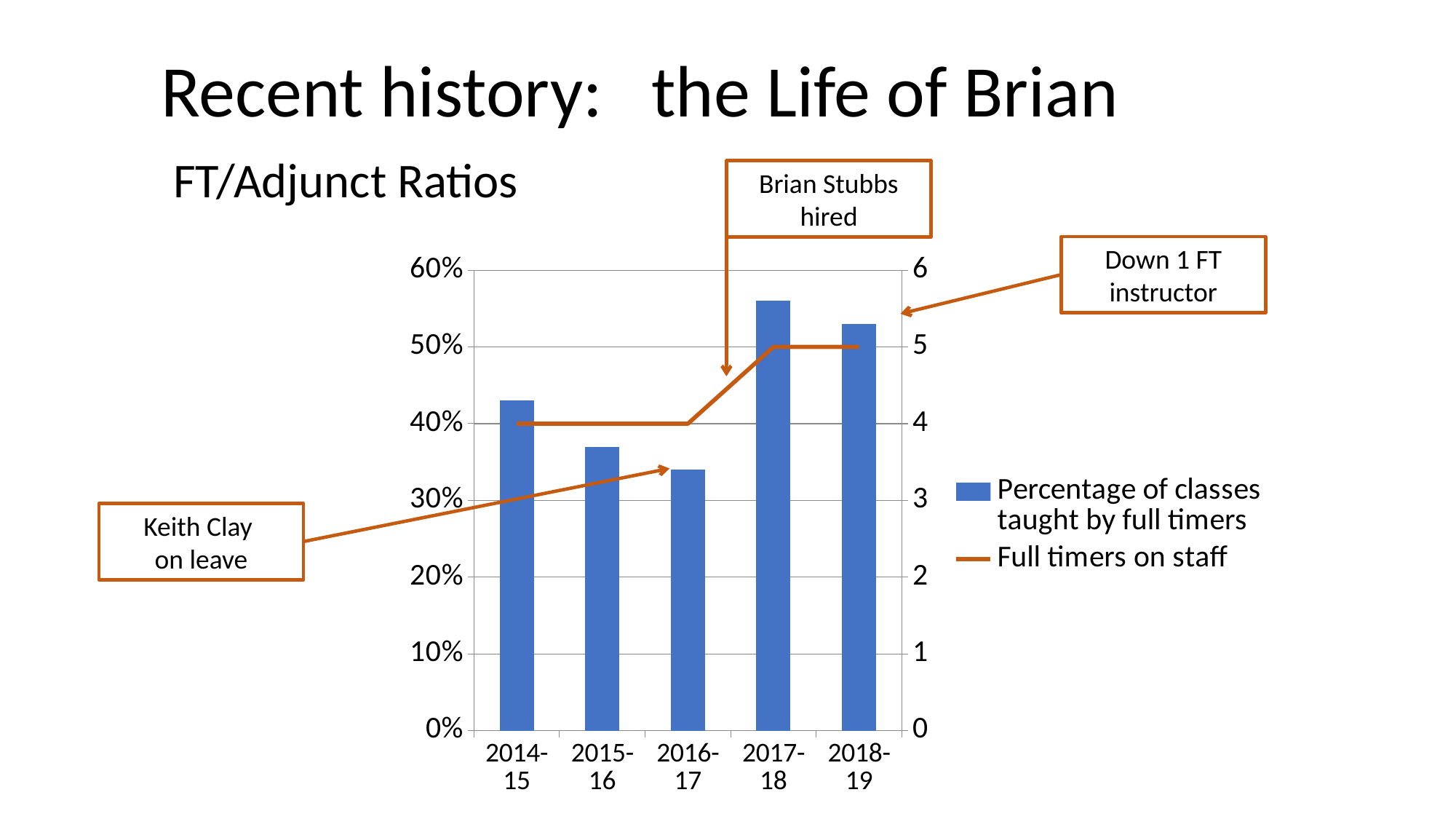
Is the percentage of classes taught by full timers in 2017-18 greater or less than 50%? greater Is the percentage of classes taught by full timers in 2016-17 greater or less than 40%? less What is the title of the chart? FT/Adjunct Ratios Which year has the highest percentage of classes taught by full timers? 2017-18 What kind of chart is shown on the slide? A bar chart combined with a line How many full timers were on staff in 2014-15? 4 How many series does the legend list? 2 What is the difference in full timers on staff between 2017-18 and 2016-17? 1 How many full timers were on staff in 2017-18? 5 How many academic years are shown on the x axis? 5 Is the percentage of classes taught by full timers in 2014-15 greater or less than 40%? greater Which year has a higher percentage of classes taught by full timers, 2015-16 or 2017-18? 2017-18